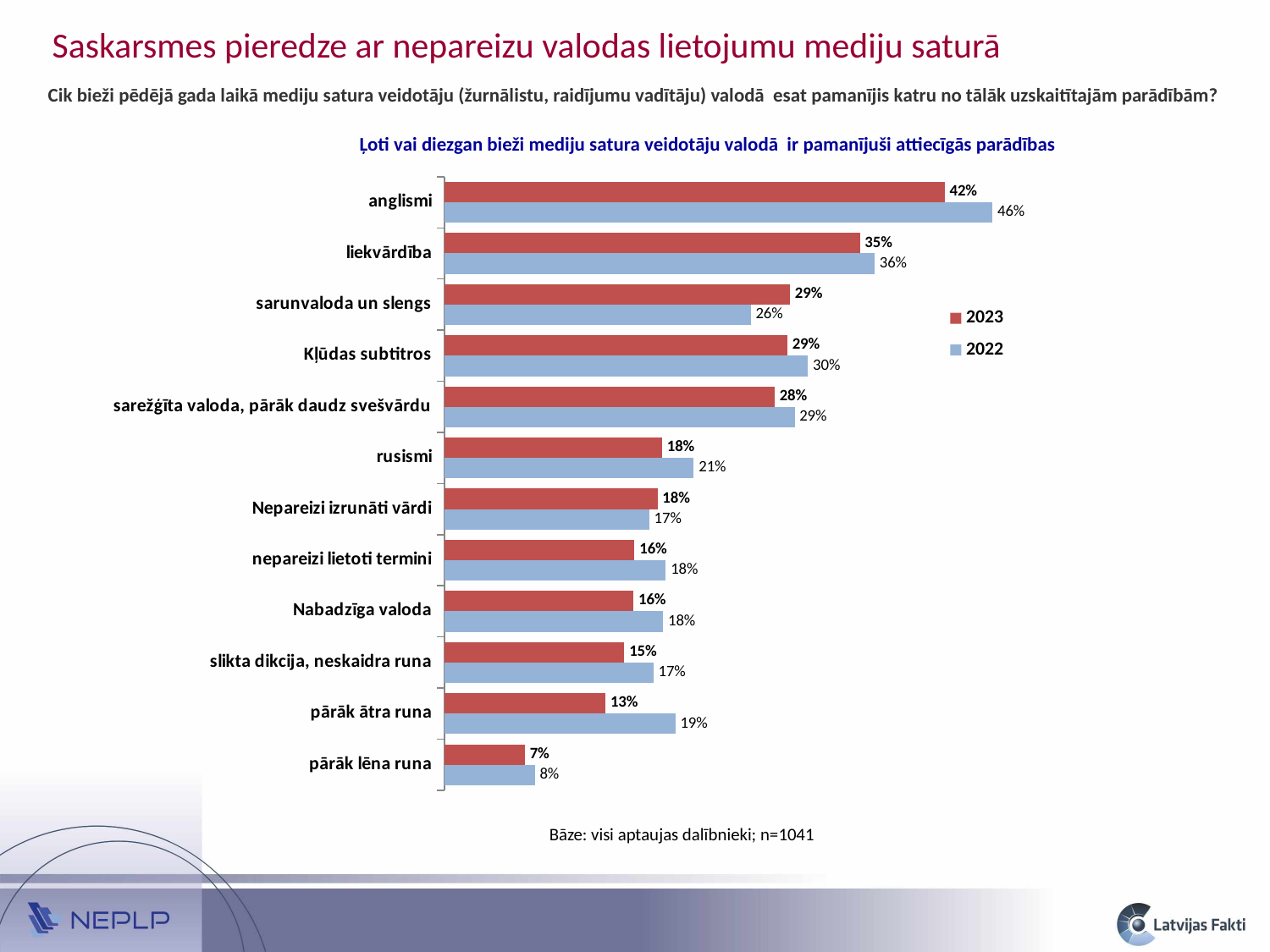
What is the 2022 value for pārāk ātra runa? 19% What is the difference between the 2023 values for anglismi and liekvārdība? 7% What is the 2022 value for sarunvaloda un slengs? 26% What is the 2023 value for anglismi? 42% How many series does the legend list? 2 For sarunvaloda un slengs, which year has the larger value, 2023 or 2022? 2023 How many categories are shown in the chart? 12 What is the difference between the 2022 and 2023 values for pārāk ātra runa? 6% Which category has the highest 2022 value? anglismi Which colour represents the 2022 series in the chart? light blue Which category has the lowest 2023 value? pārāk lēna runa What kind of chart is shown on the slide? bar chart